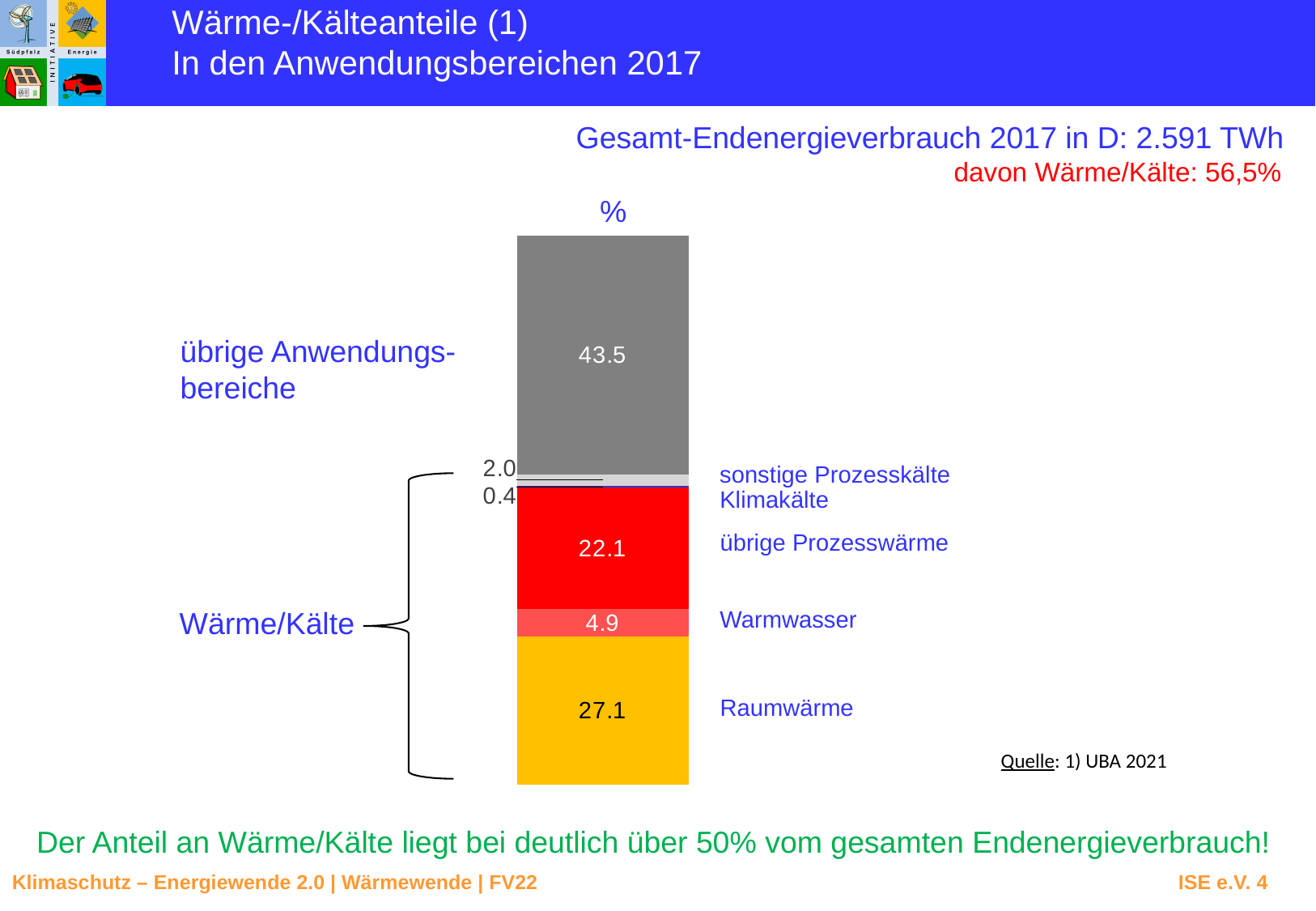
Which segment of the bar has the largest value? übrige Anwendungsbereiche What is the total of the Wärme/Kälte segments (sonstige Prozesskälte, Klimakälte, übrige Prozesswärme, Warmwasser, Raumwärme)? 56.5 What kind of chart is shown on the slide? stacked bar chart What is the value for übrige Prozesswärme? 22.1 What is the difference between the values for Raumwärme and übrige Prozesswärme? 5.0 Which is larger, the value for Warmwasser or the value for sonstige Prozesskälte? Warmwasser Which segment of the bar has the smallest value? Klimakälte What is the value for übrige Anwendungsbereiche? 43.5 How many segments make up the stacked bar? 6 What is the value for Raumwärme? 27.1 What is the value for Warmwasser? 4.9 What is the value for Klimakälte? 0.4